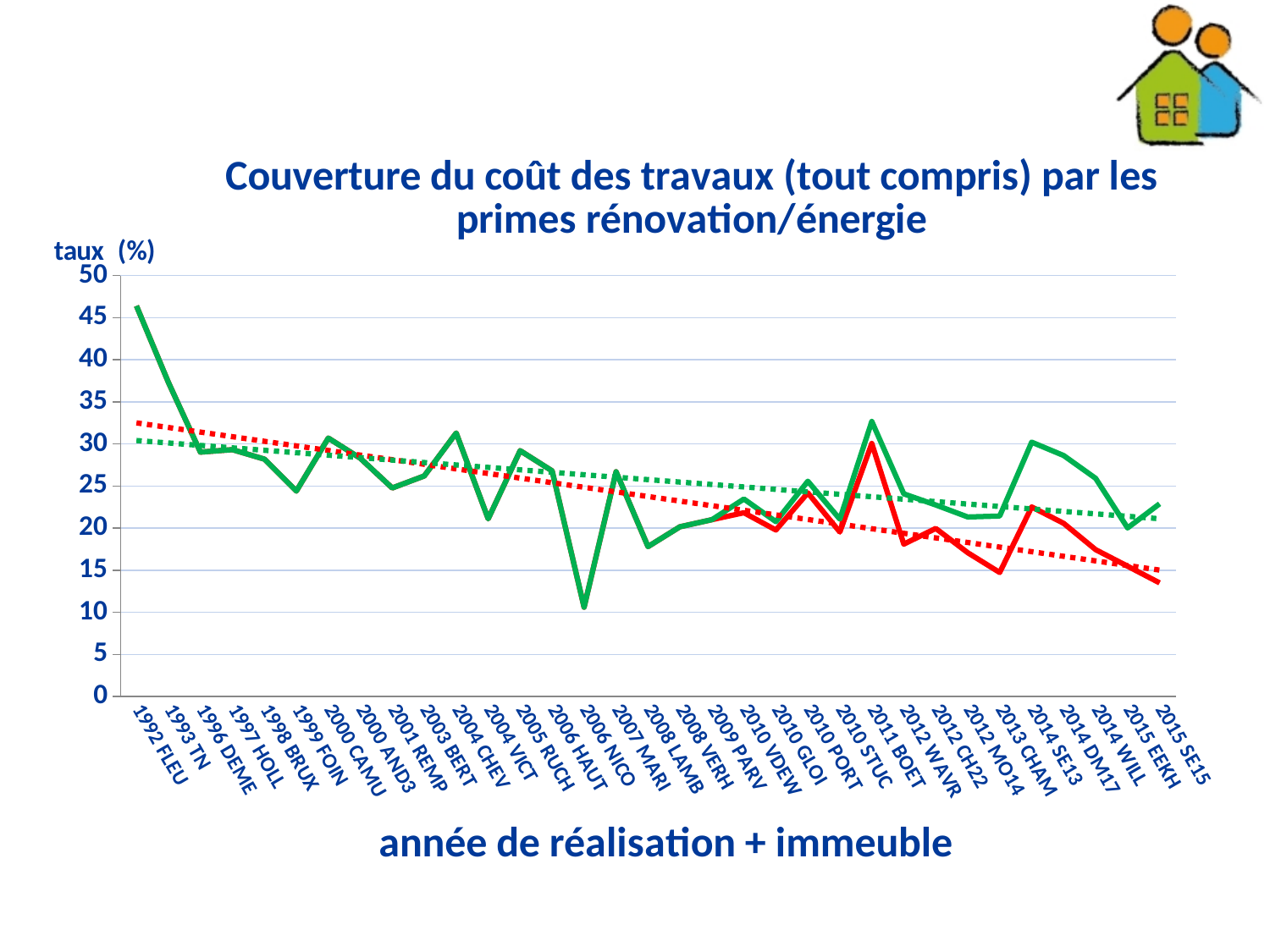
Is the red line's value for 2015 SE15 greater or less than 15? less How many categories are shown on the x axis? 33 What is the x-axis title of the chart? année de réalisation + immeuble Is the green line's value for 1992 FLEU greater or less than 40? greater Do the values of the green line generally rise or fall from left to right along the x axis? fall At 2013 CHAM, which line has the larger value, the green line or the red line? green line What is the title of the chart? Couverture du coût des travaux (tout compris) par les primes rénovation/énergie Which category has the lowest value on the green line? 2006 NICO Is the green line's value for 2006 HAUT greater or less than 15? greater Which category has the highest value on the green line? 1992 FLEU What kind of chart is shown on the slide? line chart